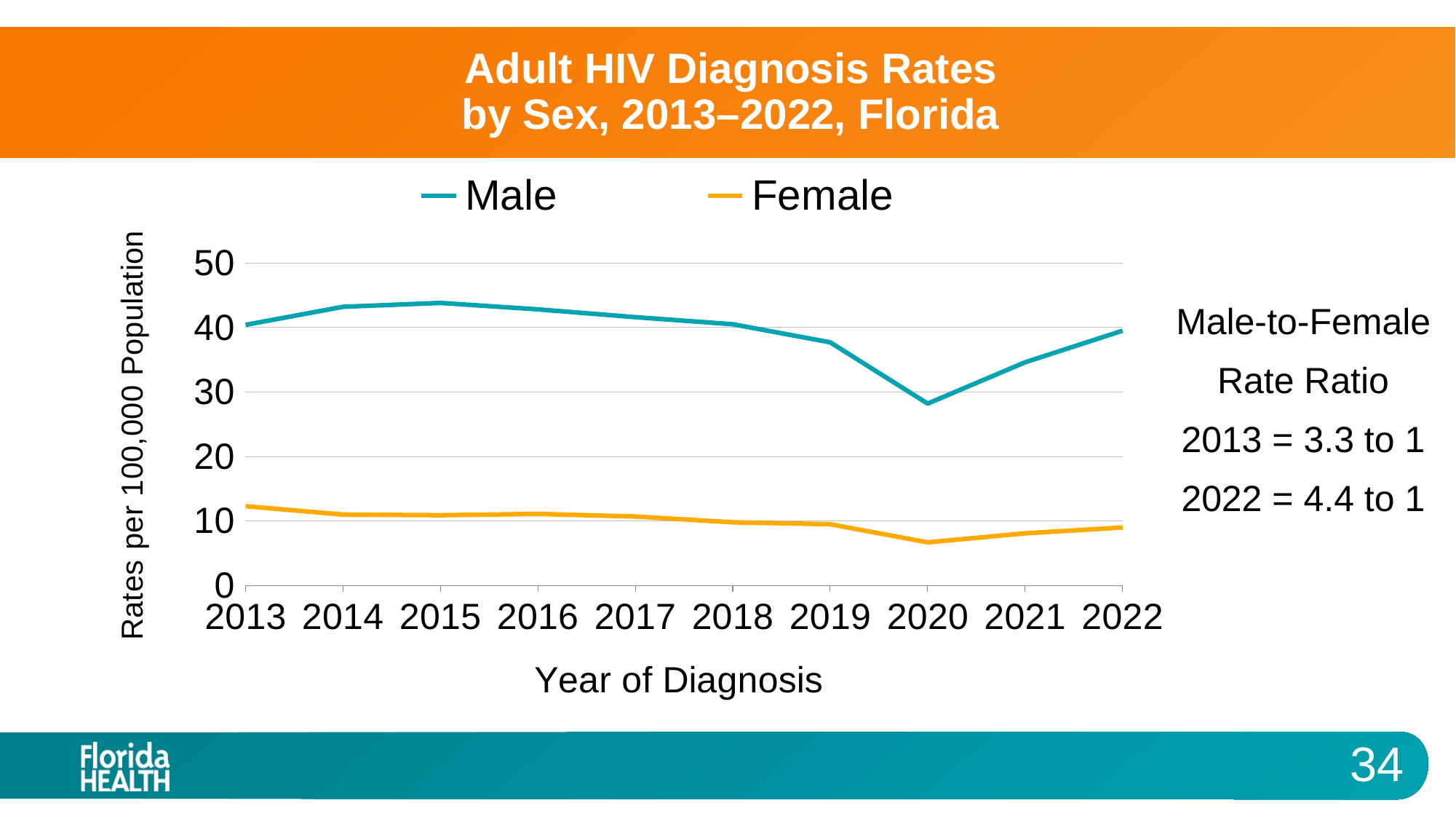
How many years are plotted along the x axis? 10 In which year is the Female diagnosis rate highest? 2013 Is the Male rate in 2015 greater or less than 40? greater Is the Male rate in 2020 greater or less than 30? less In which year is the Female diagnosis rate lowest? 2020 What kind of chart is shown on the slide? line chart Is the Female rate in 2013 greater or less than 10? greater According to the text beside the chart, what was the Male-to-Female rate ratio in 2022? 4.4 to 1 How many series does the legend list? 2 In which year is the Male diagnosis rate lowest? 2020 Which series has the higher rate in 2022, Male or Female? Male Does the Male rate rise or fall between 2020 and 2022? rise